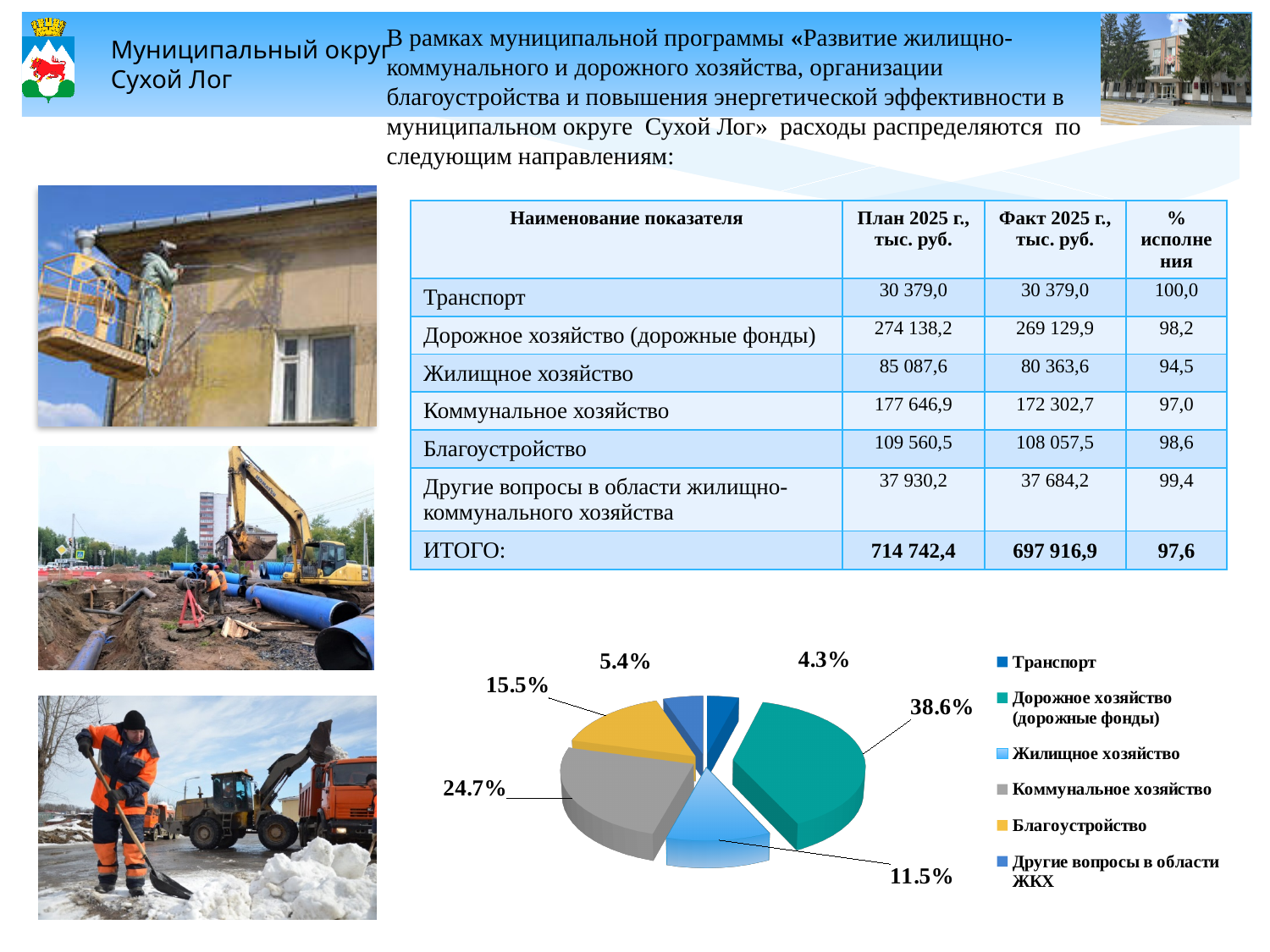
Which slice is larger: Благоустройство or Жилищное хозяйство? Благоустройство What kind of chart is shown on the slide? pie chart Which category has the largest slice in the pie chart? Дорожное хозяйство (дорожные фонды) Which category has the smallest slice in the pie chart? Транспорт In the pie chart, what share does Транспорт have? 4.3% In the pie chart, what share does Коммунальное хозяйство have? 24.7% In the pie chart, what share does Дорожное хозяйство (дорожные фонды) have? 38.6% How many categories does the pie chart legend list? 6 What is the difference in percentage points between the Дорожное хозяйство slice and the Коммунальное хозяйство slice? 13.9